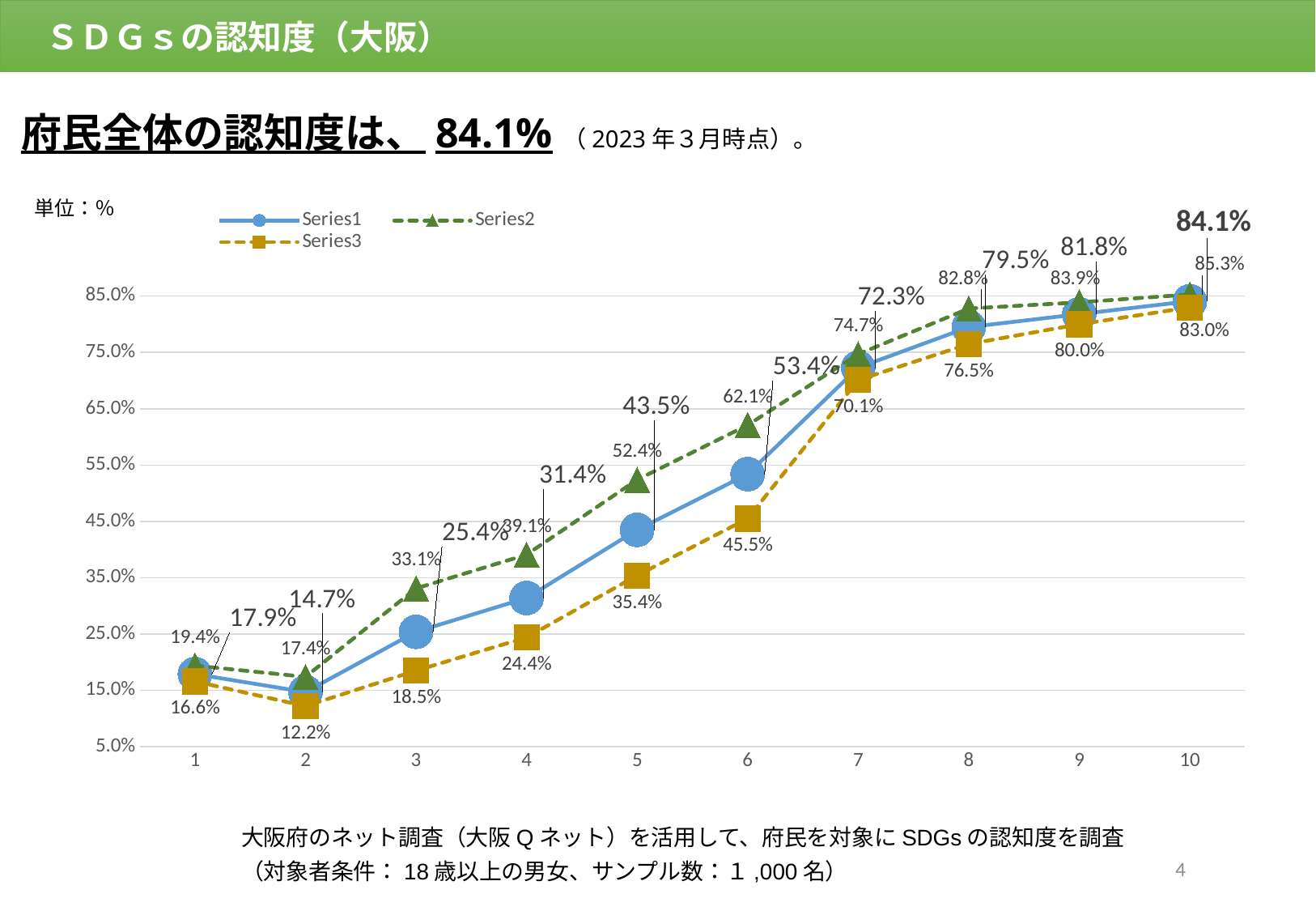
What is the value of Series1 at x = 5? 43.5% How many series does the legend list? 3 What is the value of Series3 at x = 2? 12.2% At which x value is Series1 lowest? 2 What kind of chart is shown on the slide? line chart Is the value for Series3 at x = 7 greater or less than 65.0%? greater Which is larger at x = 4: Series1 or Series3? Series1 From x = 2 to x = 10, do the Series1 values rise or fall? rise At which x value is Series2 highest? 10 What is the value of Series2 at x = 6? 62.1% What is the difference between Series2 and Series3 at x = 6? 16.6% What is the value of Series1 at x = 10? 84.1%